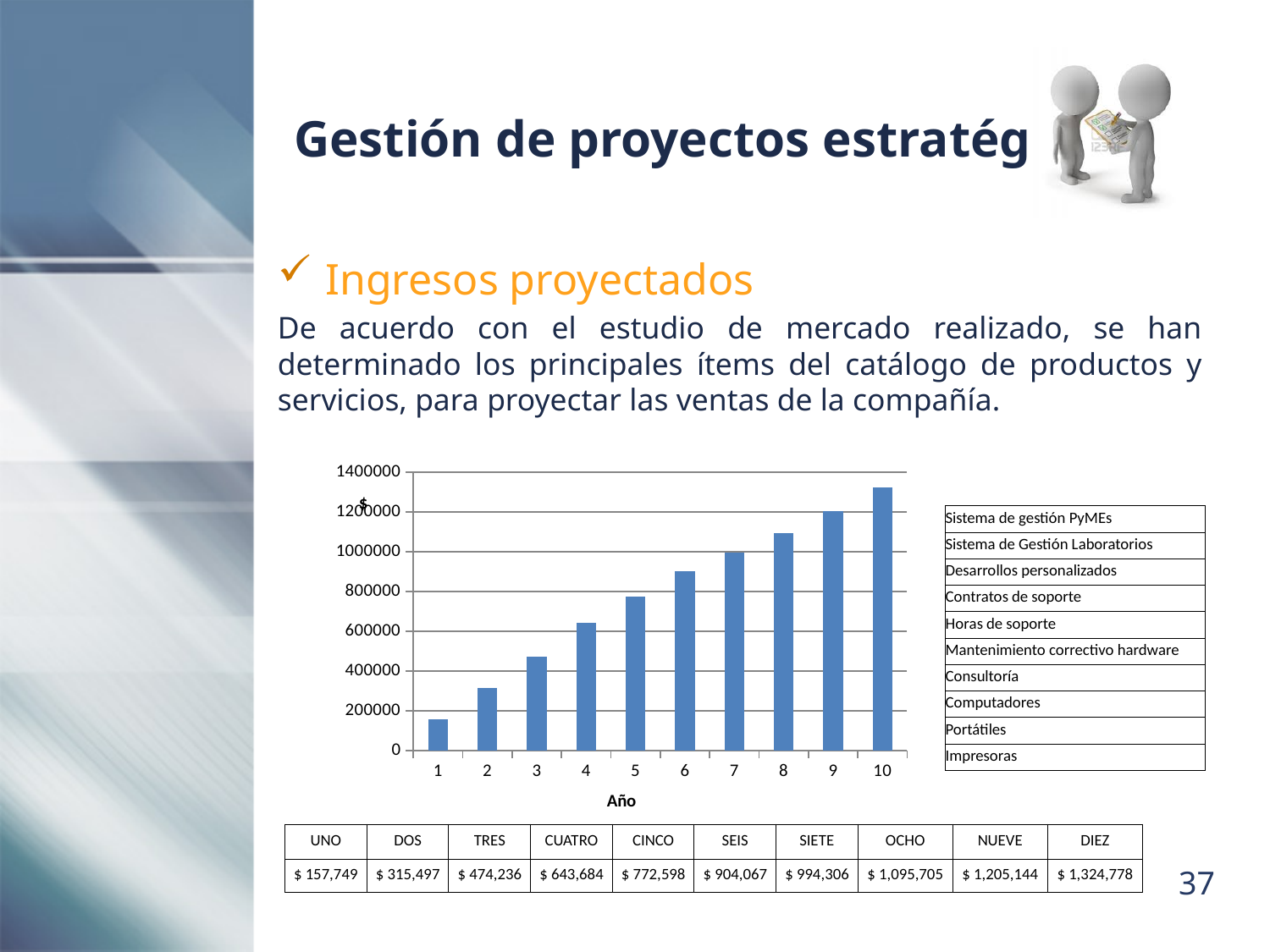
Do the values in the chart rise or fall from year 1 to year 10? rise What is the label of the x axis of the chart? Año Which is larger, the value for year 4 or the value for year 7? year 7 Is the value for year 8 greater or less than 1000000? greater Which year has the lowest bar in the chart? 1 According to the table below the chart, what is the projected income for year DIEZ? $ 1,324,778 Is the value for year 5 greater or less than 800000? less Which year has the highest bar in the chart? 10 Is the value for year 3 greater or less than 600000? less What kind of chart is shown on the slide? bar chart How many bars (years) are plotted in the chart? 10